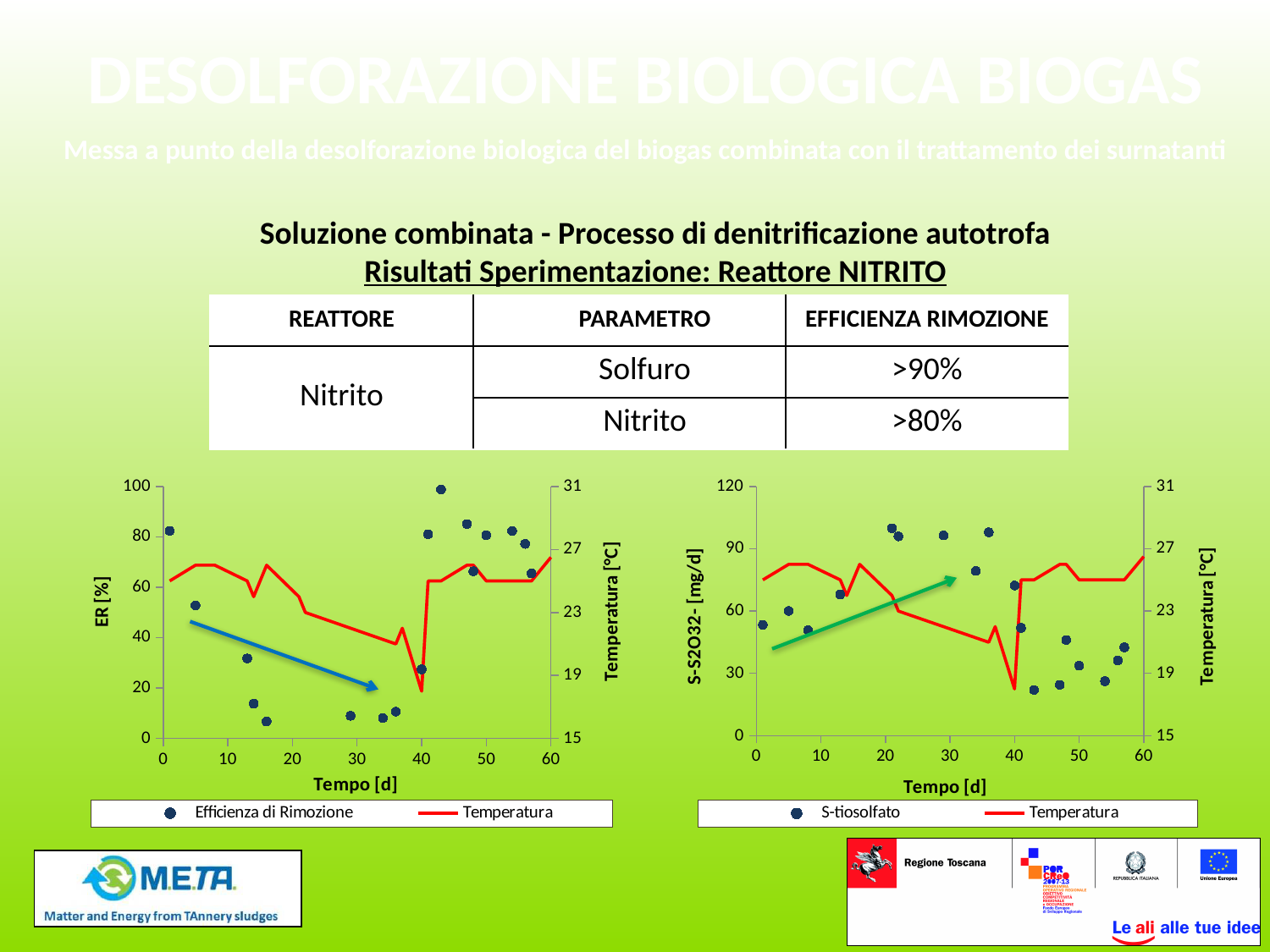
In the left chart, is the Efficienza di Rimozione value at day 0 greater or less than 60? greater In the right chart, does the S-tiosolfato value rise or fall between day 0 and day 35? rise In the right chart, is the Temperatura value at day 60 greater or less than 23? greater In the left chart, what is the label of the right-hand vertical axis? Temperatura [°C] In the right chart, is the S-tiosolfato value at about day 21 greater or less than 90? greater In the left chart, does the Efficienza di Rimozione rise or fall between day 5 and day 30? fall What kind of chart is the left chart (ER [%] vs Tempo [d])? Scatter chart with a line series In the left chart (ER [%] vs Tempo [d]), how many series does the legend list? 2 In the right chart (S-S2O32- vs Tempo [d]), what are the two series named in the legend? S-tiosolfato and Temperatura